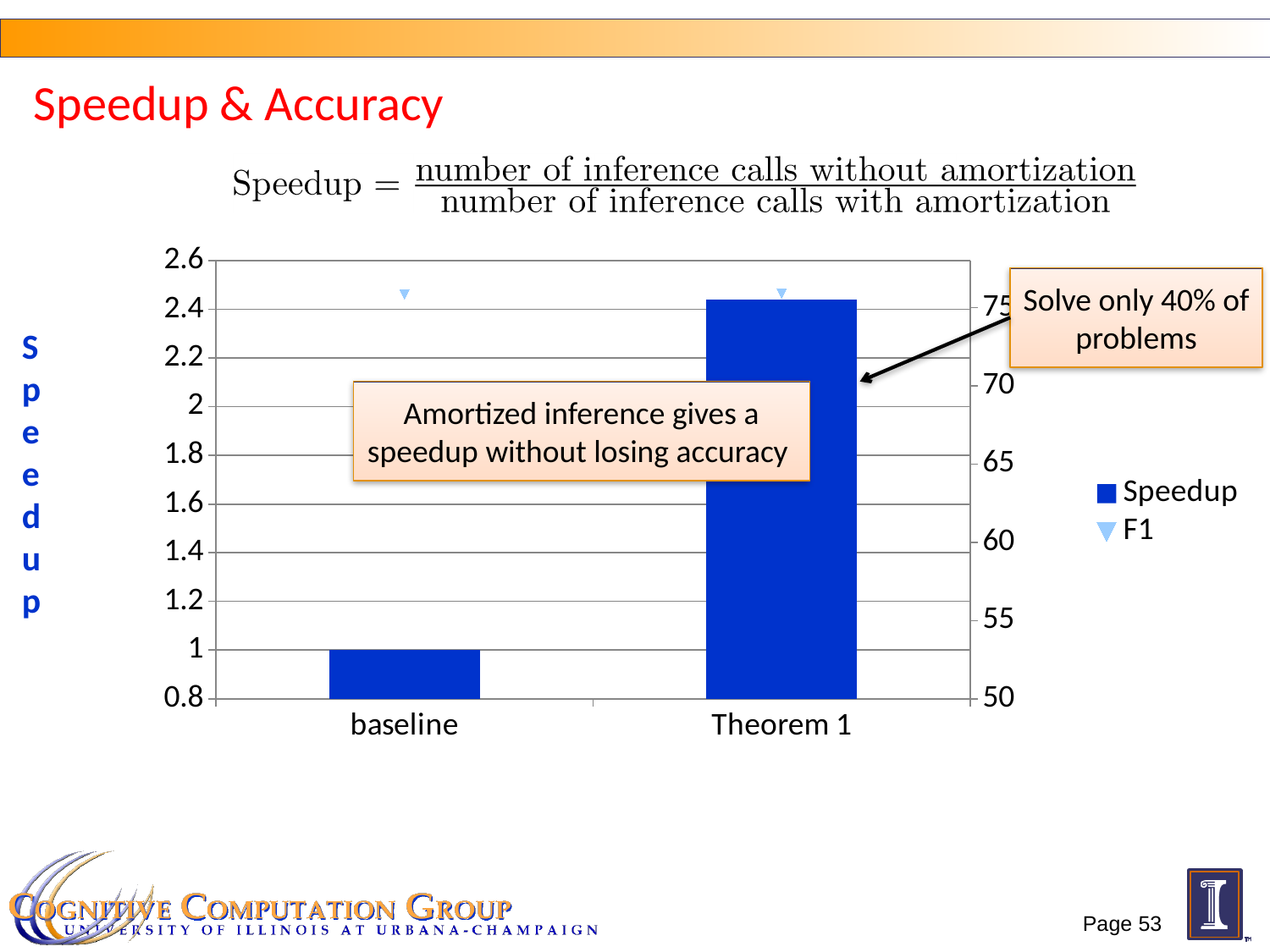
Which has a larger Speedup, baseline or Theorem 1? Theorem 1 Does the Speedup rise or fall from baseline to Theorem 1? rise Is the Speedup value for Theorem 1 greater or less than 2.2? greater Is the F1 value for baseline greater or less than 70? greater What is the title of the slide containing the chart? Speedup & Accuracy How many series does the chart's legend list? 2 Which category has the highest Speedup? Theorem 1 What kind of chart is shown on the slide? bar chart How many categories are shown on the x axis of the chart? 2 What is the Speedup value for baseline? 1 What are the two series listed in the chart's legend? Speedup and F1 Which category has the lowest Speedup? baseline